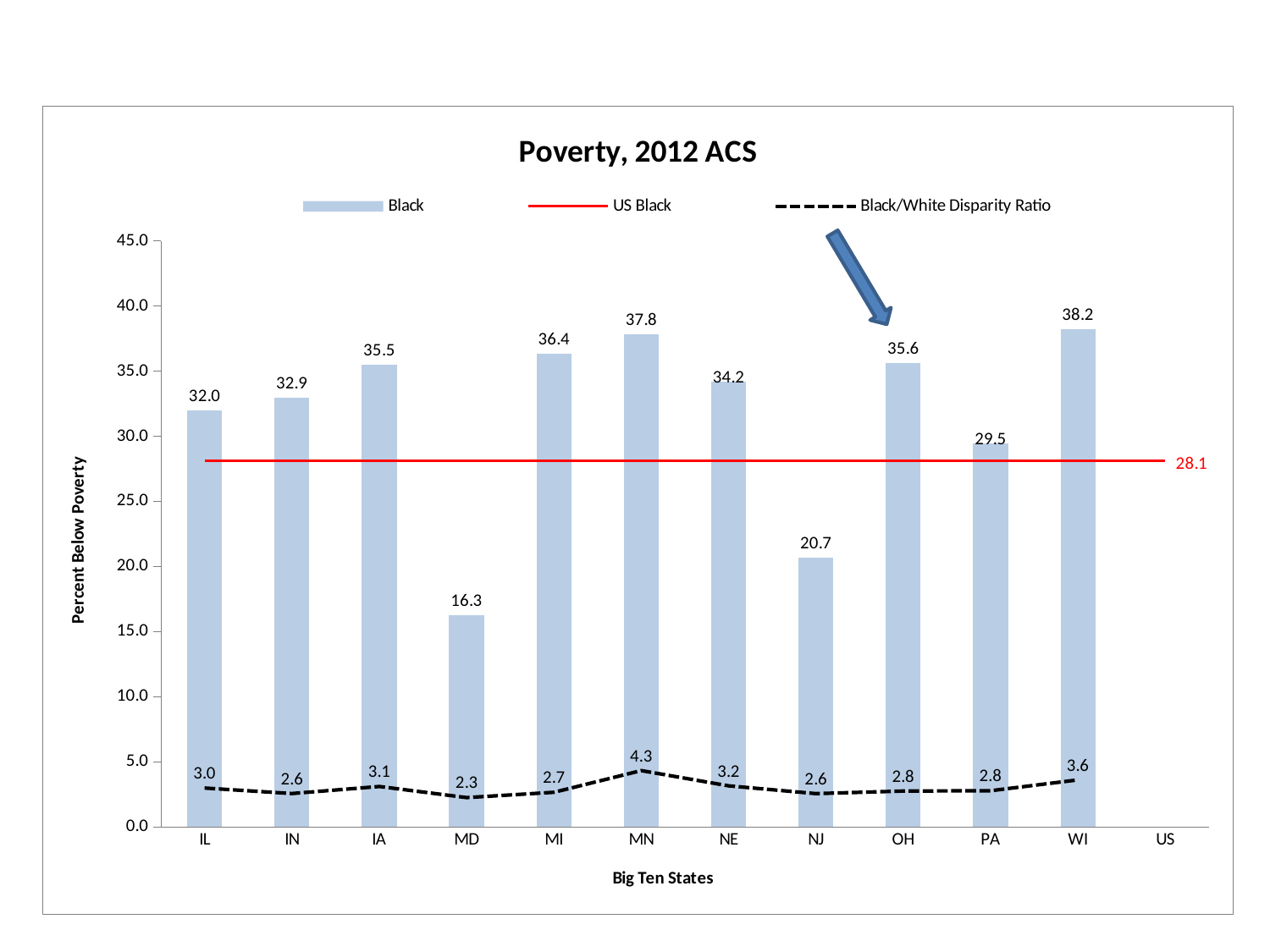
What is the Black/White Disparity Ratio for Minnesota (MN)? 4.3 How many series does the legend list? 3 Which state has the highest Black poverty rate? WI Which has a higher Black poverty rate, NJ or PA? PA What is the difference between the Black poverty rates of WI and MD? 21.9 Which state has the lowest Black poverty rate? MD Which state has the lowest Black/White Disparity Ratio? MD What is the value of the US Black line? 28.1 What is the Black poverty rate for Ohio (OH)? 35.6 What is the label of the y axis? Percent Below Poverty How many states have a Black poverty bar plotted? 11 What is the title of the chart? Poverty, 2012 ACS